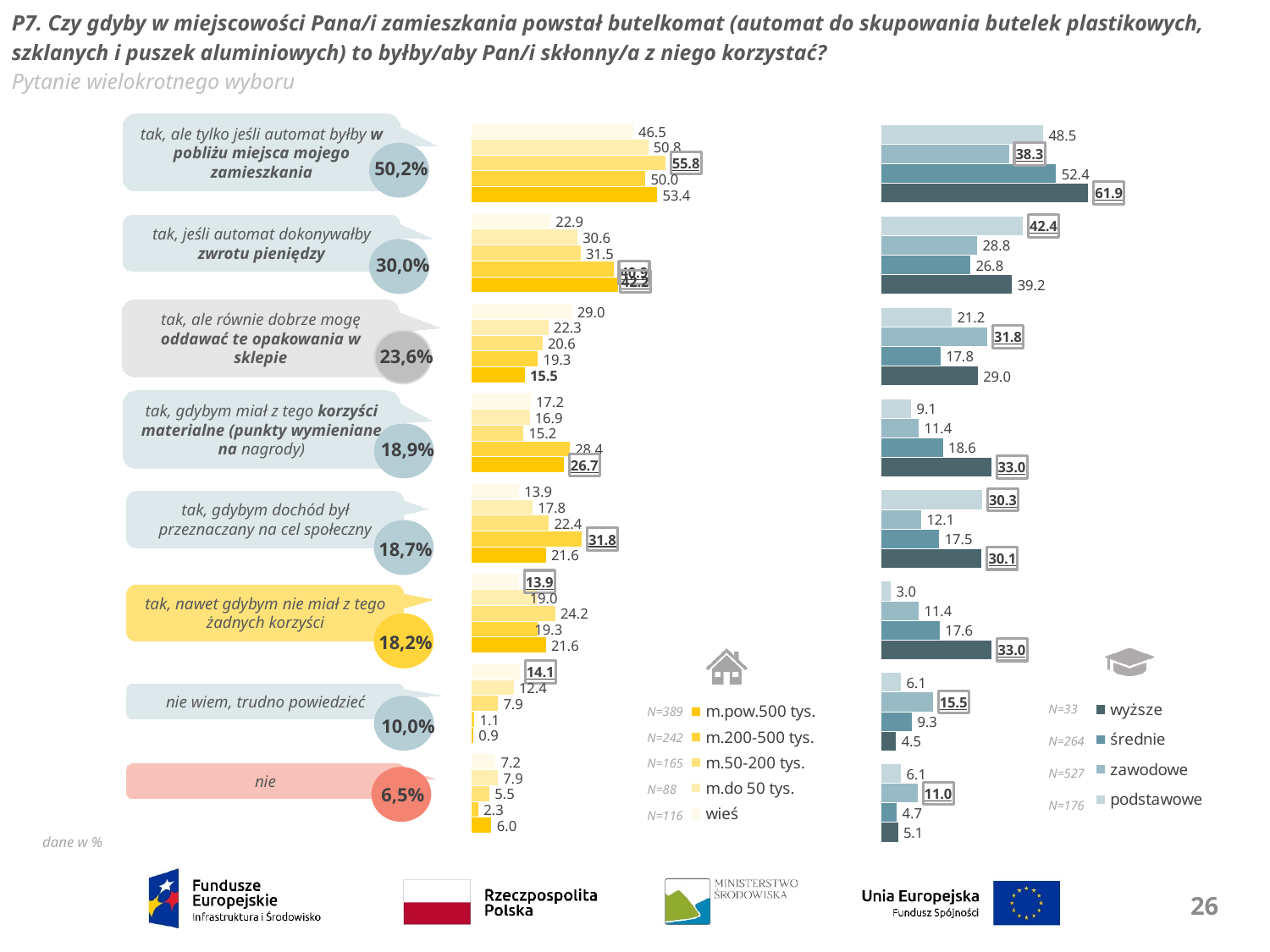
In the right (blue) chart, what is the value for 'wyższe' for 'tak, ale tylko jeśli automat byłby w pobliżu miejsca mojego zamieszkania'? 61.9 In the right (blue) chart, what sample size (N) is given for 'wyższe'? N=33 In the right (blue) chart, what is the difference between 'wyższe' (61.9) and 'podstawowe' (48.5) for 'tak, ale tylko jeśli automat byłby w pobliżu miejsca mojego zamieszkania'? 13.4 What is the overall percentage shown for the response 'nie'? 6,5% In the left (yellow) chart, for 'nie wiem, trudno powiedzieć', which is larger: the value for 'wieś' or for 'm.pow.500 tys.'? wieś How many response categories are shown on the slide? 8 Which response has the highest overall percentage? tak, ale tylko jeśli automat byłby w pobliżu miejsca mojego zamieszkania What is the overall percentage shown for 'tak, ale tylko jeśli automat byłby w pobliżu miejsca mojego zamieszkania'? 50,2% What kind of chart is used on this slide to show the results by town size and by education? bar chart In the left (yellow) chart, how many series does the legend list? 5 In the left (yellow) chart, what is the value for 'm.pow.500 tys.' for 'tak, ale równie dobrze mogę oddawać te opakowania w sklepie'? 15.5 In the right (blue) chart, how many series does the legend list? 4